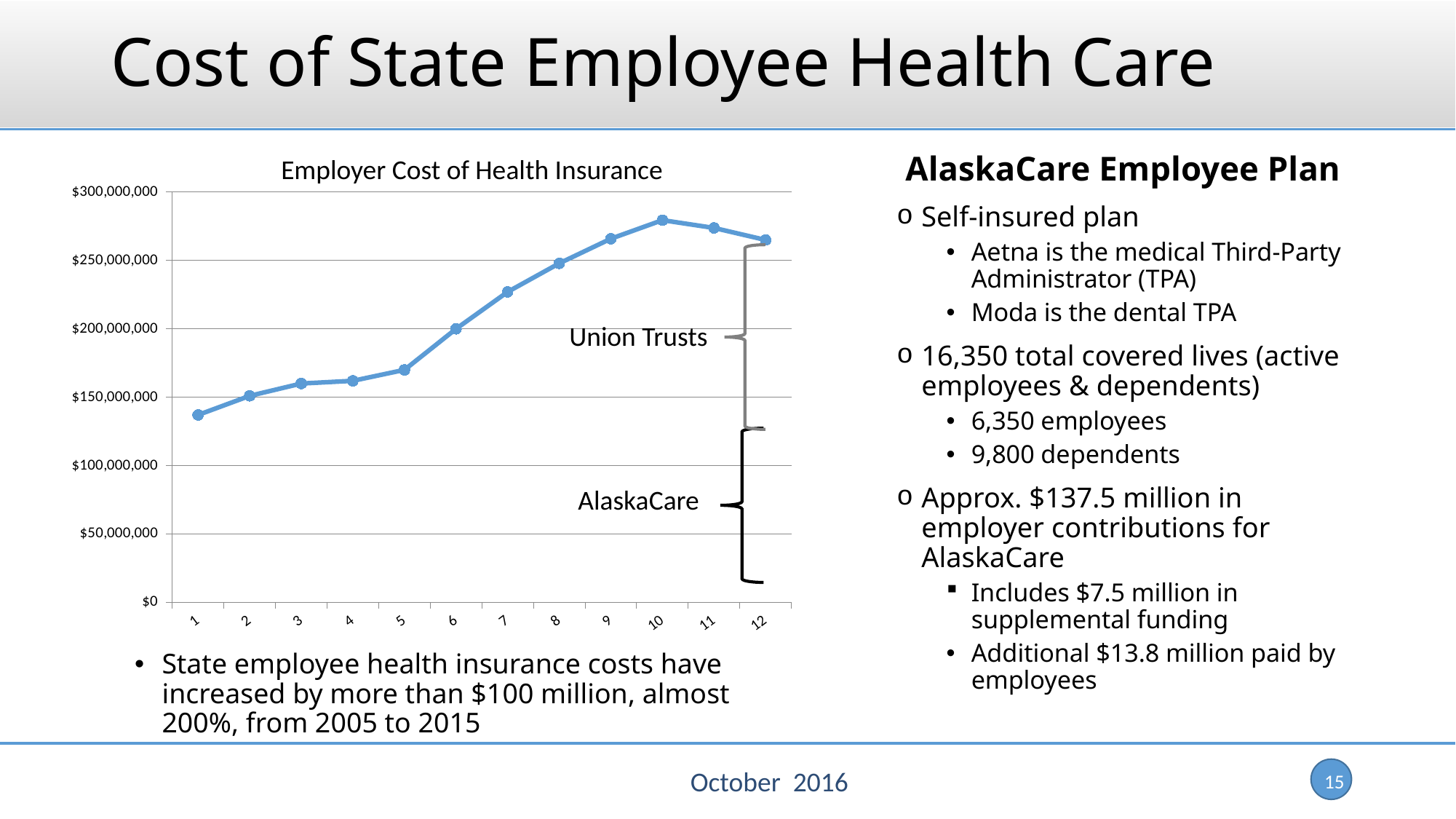
Do the values rise or fall from point 1 to point 10? rise What is the title of the chart? Employer Cost of Health Insurance How many data points are plotted on the Employer Cost of Health Insurance chart? 12 Is the value at point 3 greater or less than $150,000,000? greater Which two components are labelled with brackets on the right side of the chart? Union Trusts and AlaskaCare Which point on the x axis has the highest employer cost of health insurance? 10 Is the value at point 10 greater or less than $250,000,000? greater Which point on the x axis has the lowest employer cost of health insurance? 1 What kind of chart is the Employer Cost of Health Insurance chart? line chart Is the value at point 1 greater or less than $150,000,000? less Which is larger, the value at point 7 or the value at point 4? point 7